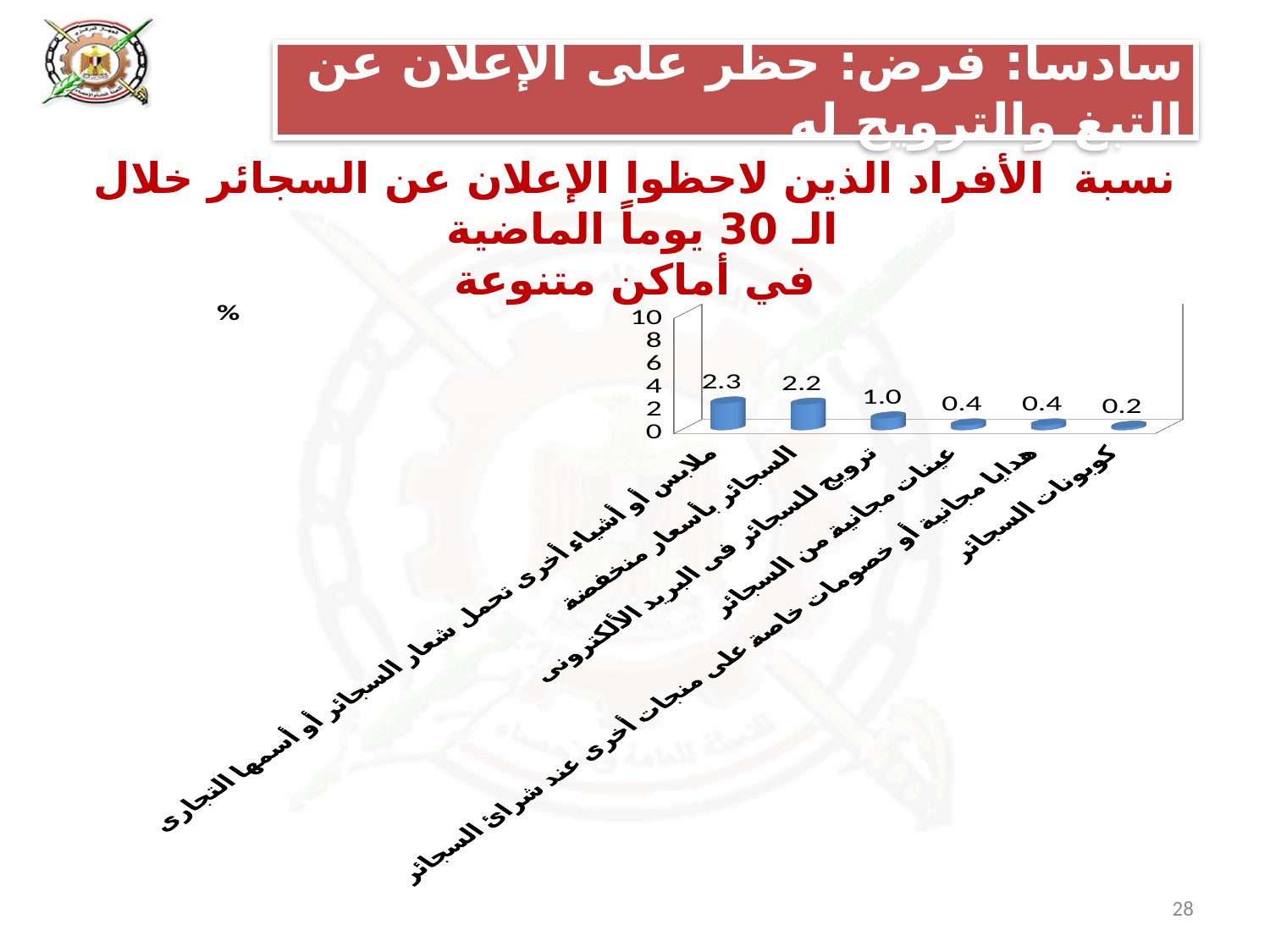
What is the value for "كوبونات السجائر" (cigarette coupons)? 0.2 Do the values rise or fall from left to right along the x axis? Fall Which category has the highest value? ملابس أو أشياء أخرى تحمل شعار السجائر أو أسمها التجاري How many categories are shown in the chart? 6 What is the highest tick value shown on the vertical axis? 10 What is the value for "السجائر بأسعار منخفضة" (cigarettes at reduced prices)? 2.2 What is the value for "ترويج للسجائر في البريد الإلكتروني" (cigarette promotion by email)? 1.0 What kind of chart is shown on the slide? Bar chart What is the difference between the value for "ملابس أو أشياء أخرى تحمل شعار السجائر أو أسمها التجاري" and the value for "كوبونات السجائر"? 2.1 Which category has the lowest value? كوبونات السجائر Which is larger: the value for "السجائر بأسعار منخفضة" or the value for "ترويج للسجائر في البريد الإلكتروني"? السجائر بأسعار منخفضة What is the value for "عينات مجانية من السجائر" (free cigarette samples)? 0.4